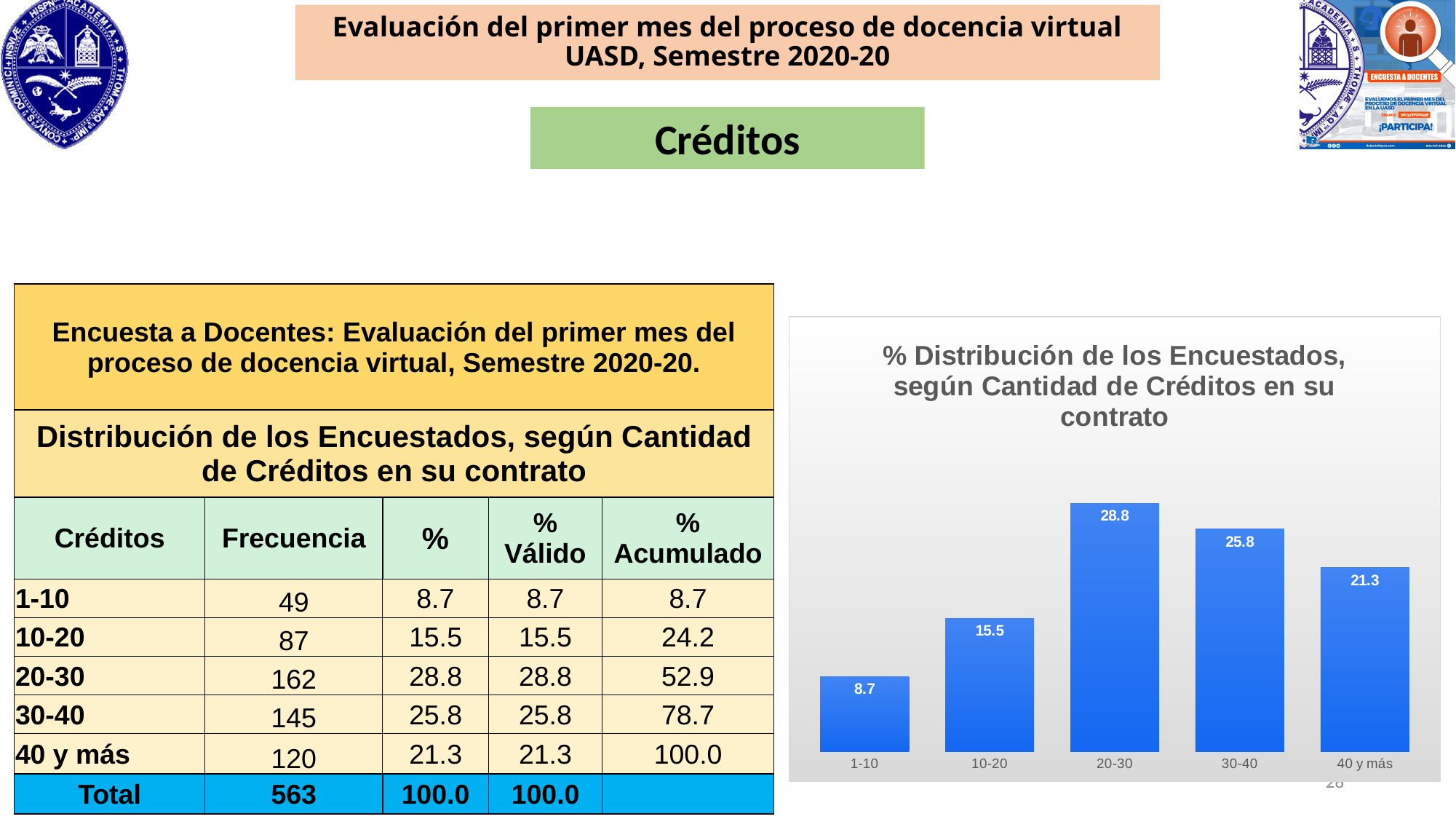
What is the difference between the values for 20-30 and 30-40 in the bar chart? 3.0 What is the value shown for the 1-10 credits category in the bar chart? 8.7 Which credits category has the highest value in the bar chart? 20-30 Which credits category has the lowest value in the bar chart? 1-10 Which has a larger value in the bar chart, 30-40 or 40 y más? 30-40 Do the values in the bar chart rise or fall from 20-30 to 40 y más? fall What is the title of the bar chart? % Distribución de los Encuestados, según Cantidad de Créditos en su contrato What is the value shown for the 20-30 credits category in the bar chart? 28.8 What type of chart is shown on the slide? bar chart How many categories are shown in the bar chart? 5 What is the difference between the values for 10-20 and 1-10 in the bar chart? 6.8 What is the value shown for the 40 y más category in the bar chart? 21.3